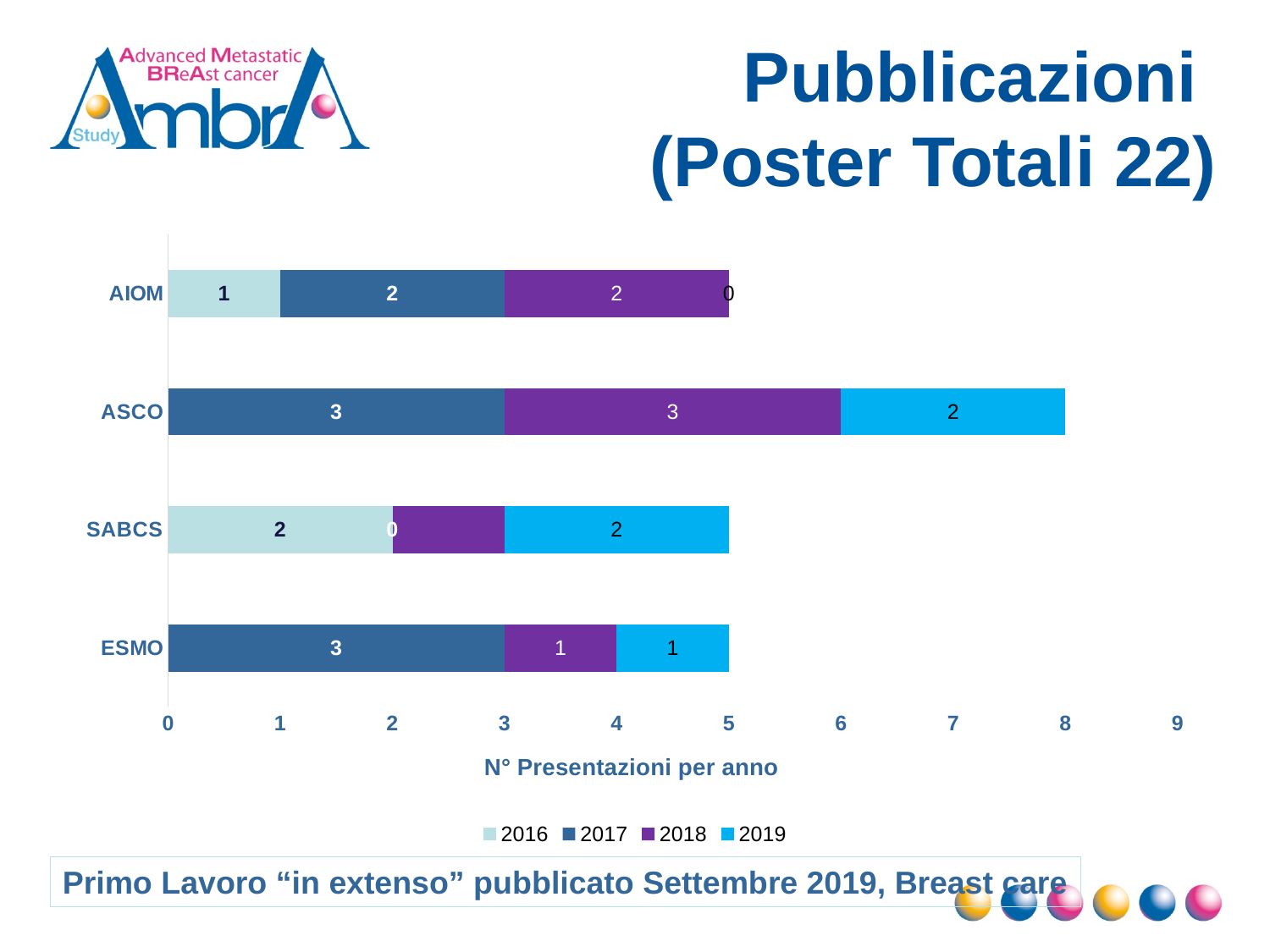
Which category has the longest total bar? ASCO What is the difference between the 2017 value for ASCO and the 2018 value for ESMO? 2 How many categories (conferences) are shown on the chart? 4 What is the total of the stacked bar for ASCO? 8 What is the value for ASCO in 2018? 3 How many series does the legend list? 4 Which is larger, the 2019 value for ASCO or the 2019 value for ESMO? ASCO What is the title of the horizontal axis? N° Presentazioni per anno What is the value for SABCS in 2019? 2 What is the value for AIOM in 2016? 1 What kind of chart is shown on the slide? Stacked bar chart What is the value for ESMO in 2017? 3